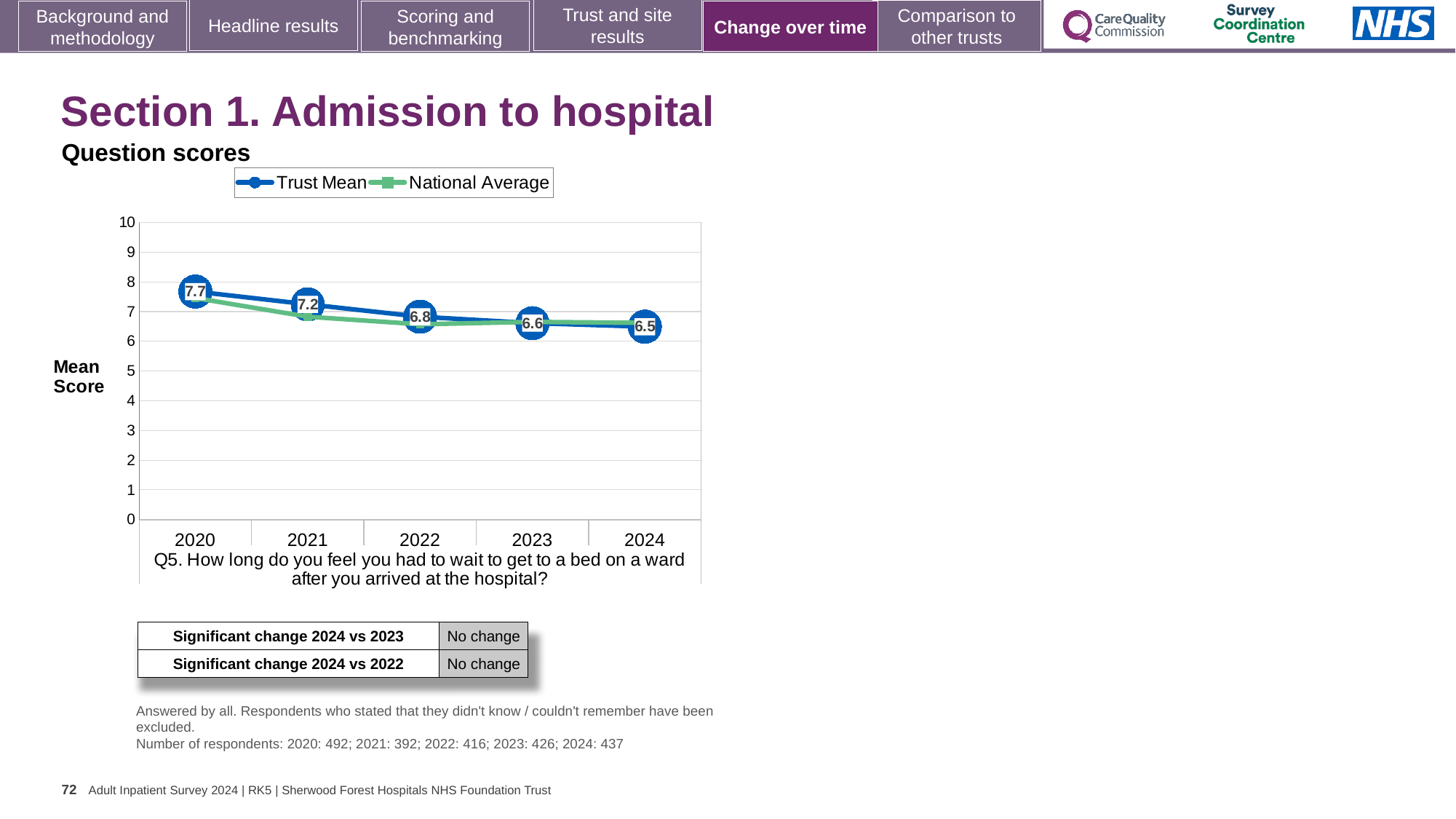
What is the Trust Mean score for 2022? 6.8 What kind of chart is shown on the slide? line chart What is the difference between the Trust Mean score in 2020 and in 2024? 1.2 How many series does the legend list? 2 In which year is the Trust Mean score lowest? 2024 How many years are plotted on the x axis? 5 Does the Trust Mean score rise or fall from 2020 to 2024? fall What is the Trust Mean score for 2024? 6.5 What is the Trust Mean score for 2020? 7.7 In which year is the Trust Mean score highest? 2020 Which is larger, the Trust Mean score in 2021 or in 2023? 2021 Is the National Average value for 2020 greater or less than 7? greater